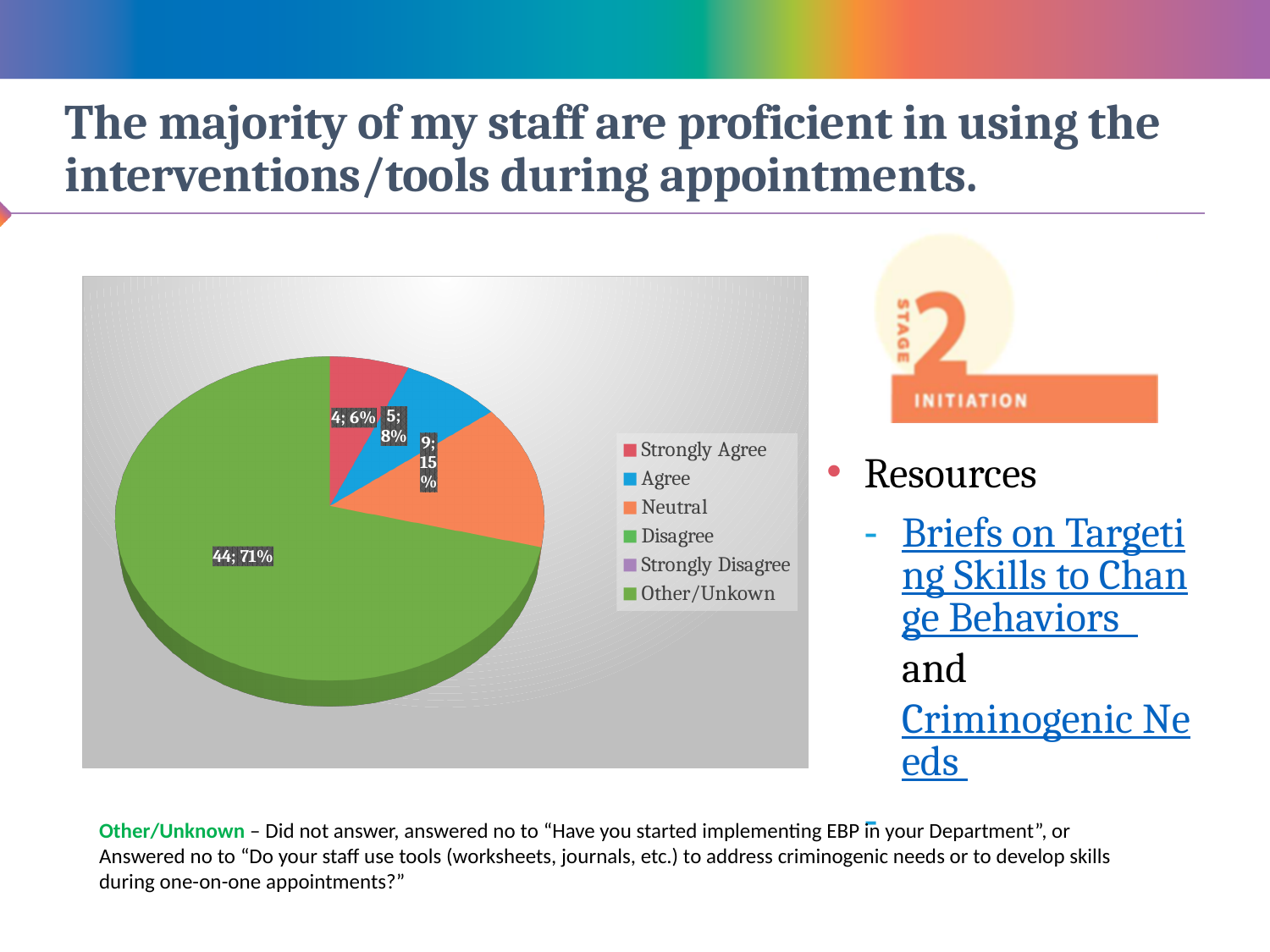
What percentage share is shown for the Neutral slice? 15% How many entries does the legend of the pie chart list? 6 Which category has the largest slice of the pie? Other/Unknown What percentage share is shown for the Agree slice? 8% What count is shown for the Strongly Agree slice? 4 Which of the labelled slices is the smallest? Strongly Agree What count is shown for the Other/Unknown slice? 44 What count is shown for the Neutral slice? 9 What is the difference in count between the Neutral slice and the Agree slice? 4 What percentage share is shown for the Other/Unknown slice? 71% What kind of chart is shown on the slide? pie chart